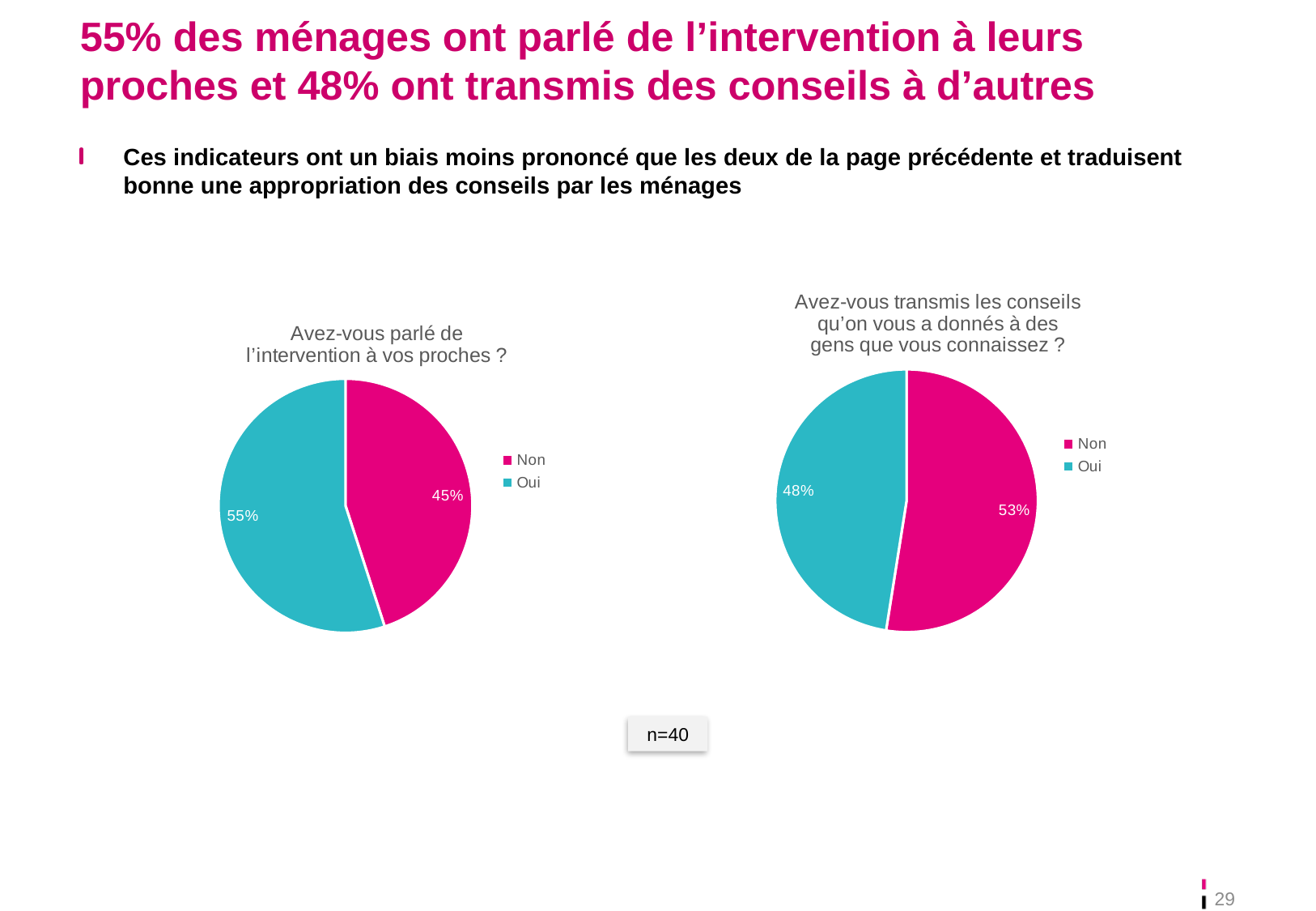
In the right pie chart 'Avez-vous transmis les conseils qu'on vous a donnés à des gens que vous connaissez ?', what share of respondents answered Non? 53% In the left pie chart 'Avez-vous parlé de l'intervention à vos proches ?', what is the difference in percentage points between Oui and Non? 10 percentage points In the right pie chart 'Avez-vous transmis les conseils qu'on vous a donnés à des gens que vous connaissez ?', which answer has the smaller share? Oui In the right pie chart, which colour represents the Non answer? Pink (magenta) How many categories does the legend of the left pie chart list? 2 In the left pie chart 'Avez-vous parlé de l'intervention à vos proches ?', which answer has the larger share? Oui In the left pie chart 'Avez-vous parlé de l'intervention à vos proches ?', what share of respondents answered Non? 45% Is the Oui share in the left pie chart larger or smaller than the Oui share in the right pie chart? larger In the right pie chart 'Avez-vous transmis les conseils qu'on vous a donnés à des gens que vous connaissez ?', what share of respondents answered Oui? 48% In the right pie chart 'Avez-vous transmis les conseils qu'on vous a donnés à des gens que vous connaissez ?', what is the difference in percentage points between Non and Oui? 5 percentage points In the left pie chart 'Avez-vous parlé de l'intervention à vos proches ?', what share of respondents answered Oui? 55% What type of chart is used on this slide? Pie chart